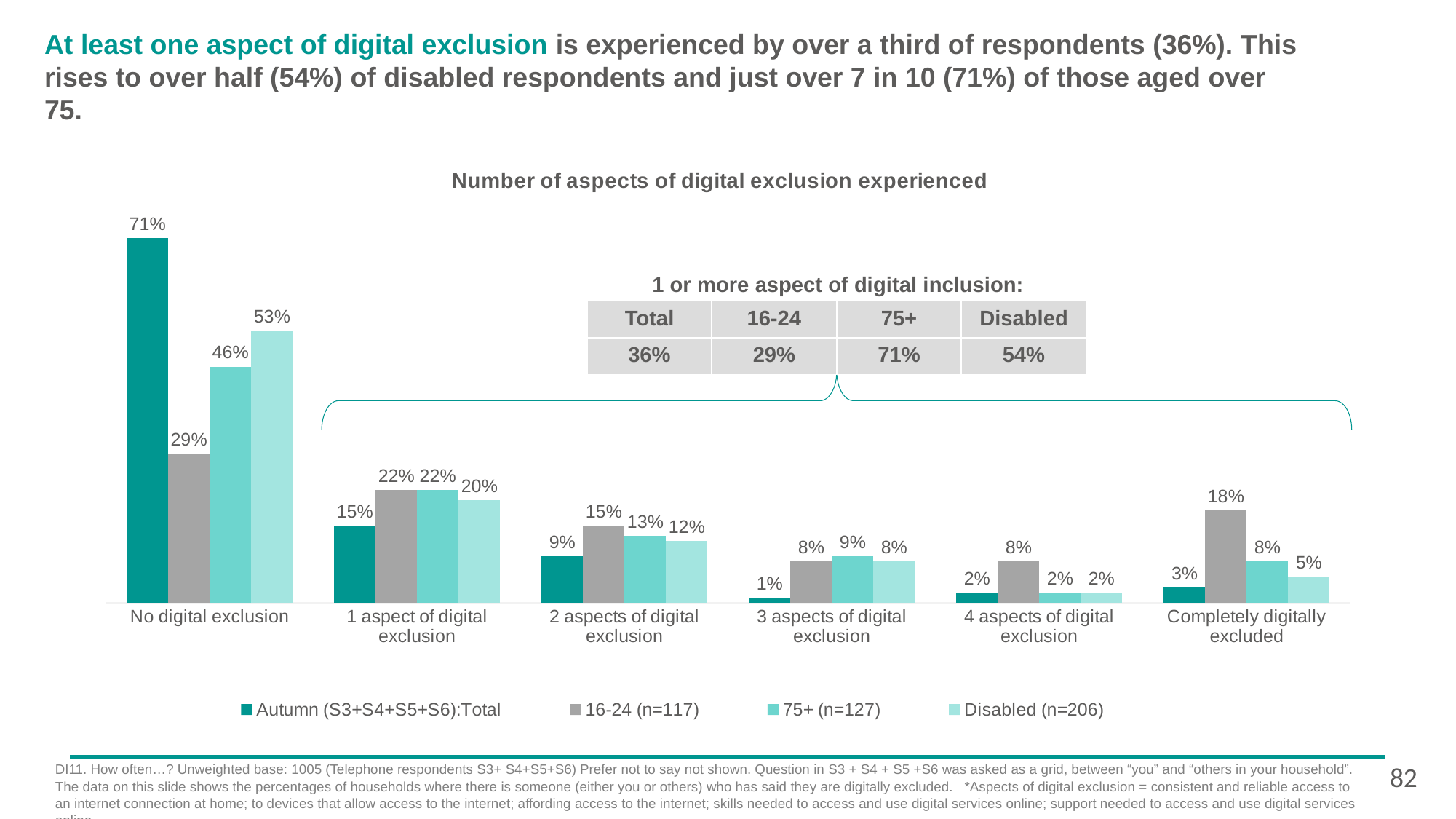
What is the difference between the Autumn (S3+S4+S5+S6):Total value and the 16-24 (n=117) value in the 'No digital exclusion' category? 42% What is the value for the 75+ (n=127) series in the '3 aspects of digital exclusion' category? 9% What is the title of the chart? Number of aspects of digital exclusion experienced Which series has the highest value in the 'No digital exclusion' category? Autumn (S3+S4+S5+S6):Total What is the value for the 16-24 (n=117) series in the 'Completely digitally excluded' category? 18% Which series has the lowest value in the '3 aspects of digital exclusion' category? Autumn (S3+S4+S5+S6):Total What is the value for the Disabled (n=206) series in the '2 aspects of digital exclusion' category? 12% In the 'Completely digitally excluded' category, which is larger: the 75+ (n=127) value or the Disabled (n=206) value? 75+ (n=127) What is the value for the Autumn (S3+S4+S5+S6):Total series in the 'No digital exclusion' category? 71% How many categories are shown on the x axis of the chart? 6 What type of chart is shown on the slide? Bar chart How many series does the chart legend list? 4